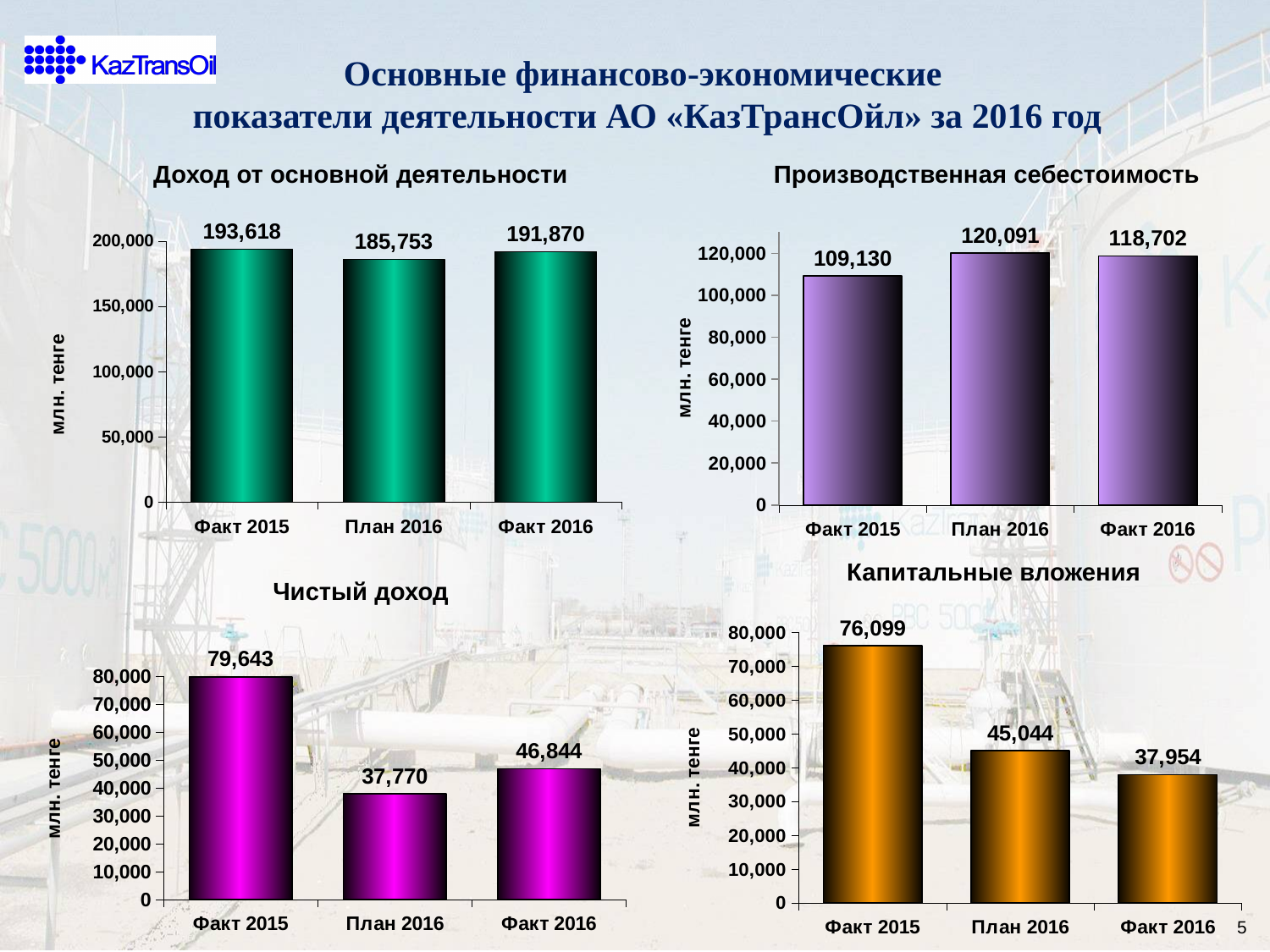
In the 'Чистый доход' chart, which is larger, Факт 2016 or План 2016? Факт 2016 In the 'Доход от основной деятельности' chart, what is the value for Факт 2016? 191,870 What type of chart is the 'Производственная себестоимость' chart? bar chart How many categories are shown in the 'Чистый доход' chart? 3 In the 'Производственная себестоимость' chart, what is the difference between План 2016 and Факт 2015? 10,961 In the 'Чистый доход' chart, which category has the highest value? Факт 2015 In the 'Капитальные вложения' chart, do the values rise or fall from Факт 2015 to Факт 2016? fall In the 'Чистый доход' chart, what is the value for План 2016? 37,770 In the 'Капитальные вложения' chart, what is the difference between Факт 2015 and Факт 2016? 38,145 In the 'Производственная себестоимость' chart, what is the value for План 2016? 120,091 In the 'Капитальные вложения' chart, what is the value for Факт 2015? 76,099 In the 'Доход от основной деятельности' chart, which category has the lowest value? План 2016